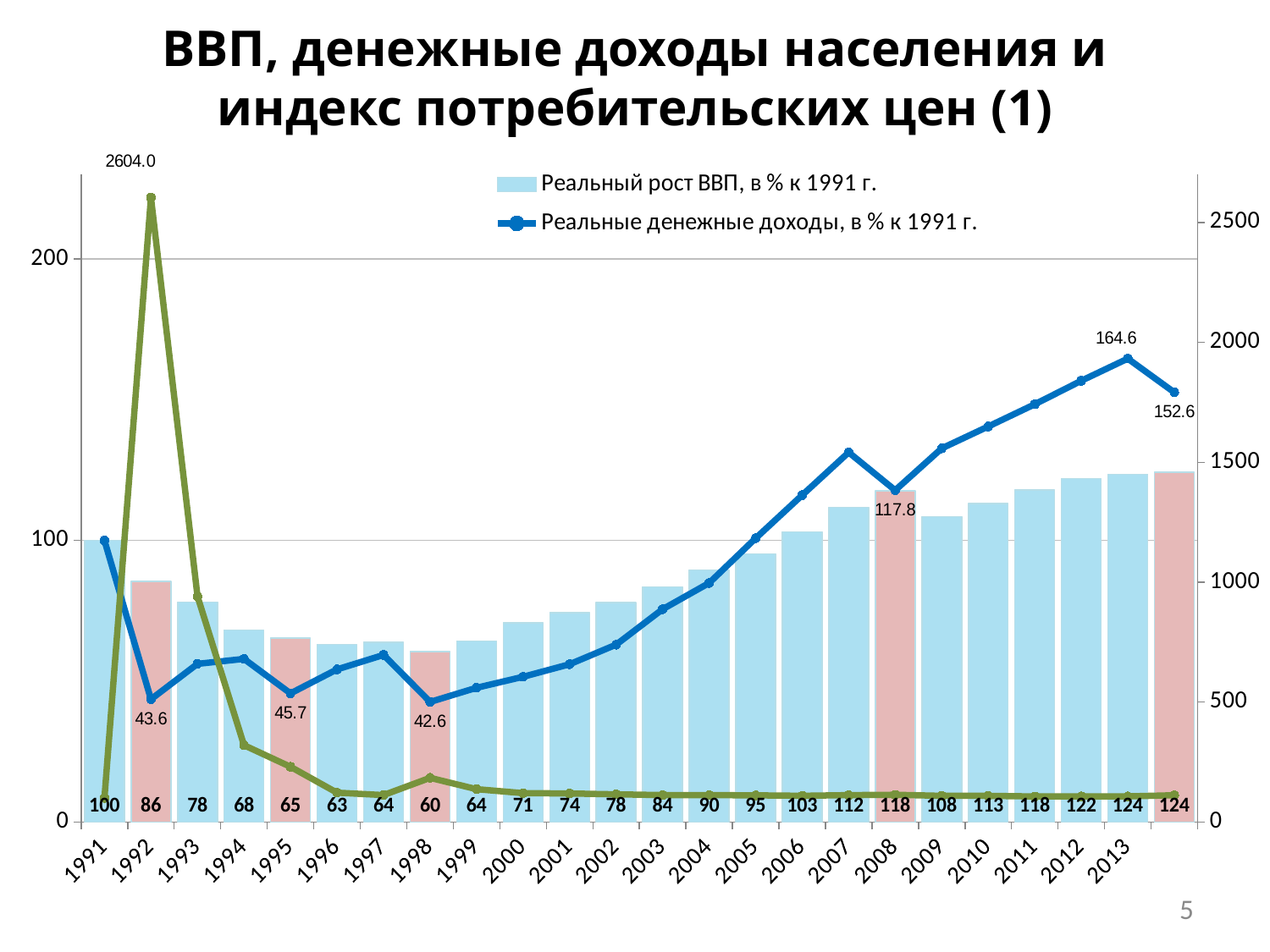
What is the difference between the real money incomes value for 2013 (164.6) and for 2008 (117.8)? 46.8 What is the labelled value of real money incomes for 1992? 43.6 What is the value of the real GDP growth bar (Реальный рост ВВП) for 1998? 60 What is the value of the real GDP growth bar for 2008? 118 Which is larger, the real GDP growth bar for 2007 or for 2009? 2007 What is the difference between the real GDP growth bar for 2013 and the bar for 1991? 24 Do the real GDP growth bars rise or fall from 1999 to 2008? rise How many series does the legend list? 2 What value is labelled at the peak of the green line in 1992? 2604.0 Which year has the lowest real GDP growth bar? 1998 What is the labelled value of real money incomes (Реальные денежные доходы) for 2013? 164.6 Is the real money incomes value for 2007 greater or less than 100? greater